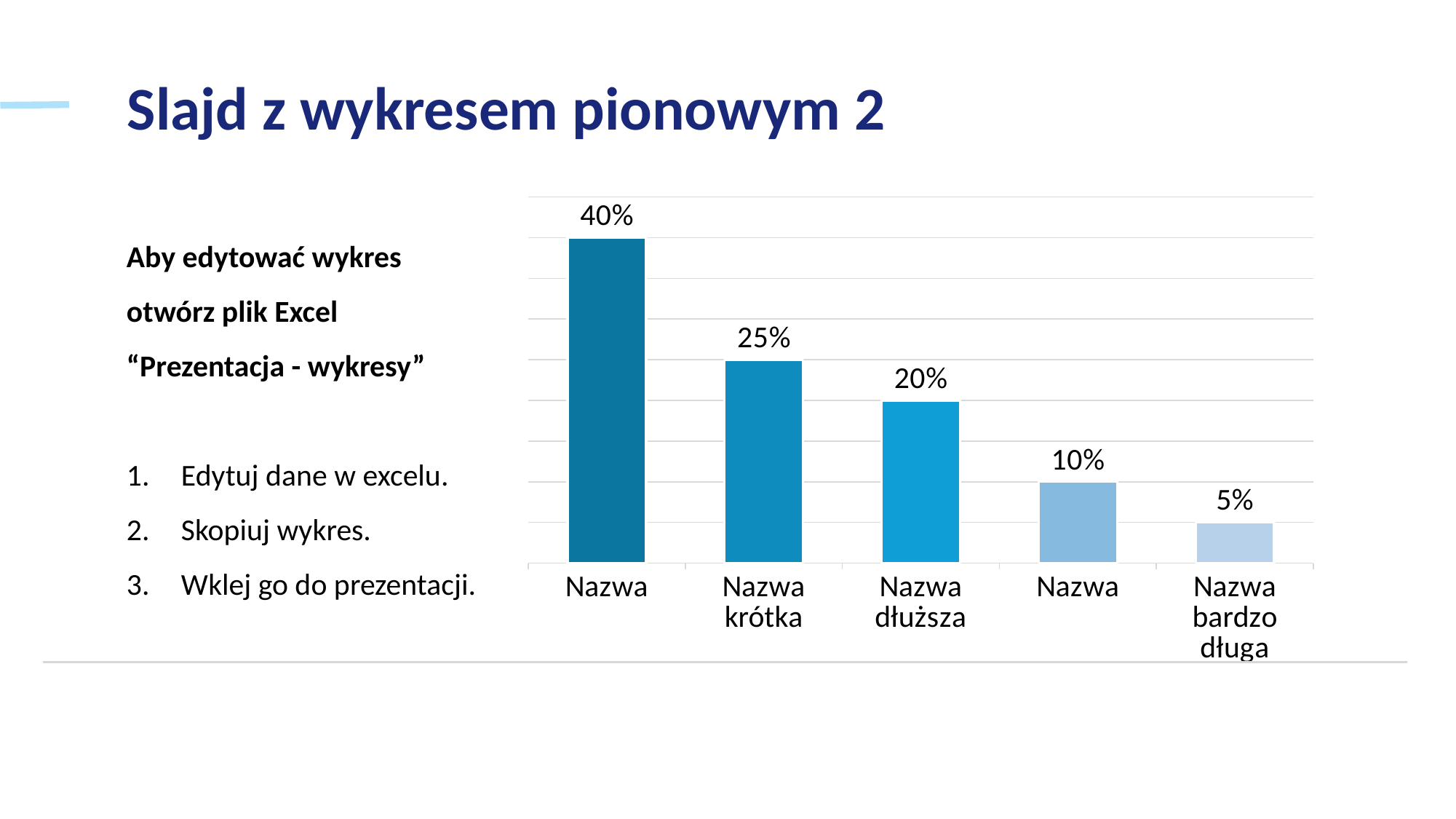
Do the bar values rise or fall from left to right across the chart? fall How many bars does the chart have? 5 What is the difference between the values for "Nazwa krótka" and "Nazwa dłuższa"? 5% Which is larger, the value for "Nazwa dłuższa" or the value for "Nazwa bardzo długa"? Nazwa dłuższa What is the value of the bar labelled "Nazwa dłuższa"? 20% What type of chart is shown on the slide? bar chart What is the value of the highest bar? 40% What is the value of the bar labelled "Nazwa krótka"? 25% Which category has the lowest value? Nazwa bardzo długa What is the value of the first (leftmost) bar? 40% What is the value of the bar labelled "Nazwa bardzo długa"? 5% What is the value of the fourth bar from the left? 10%